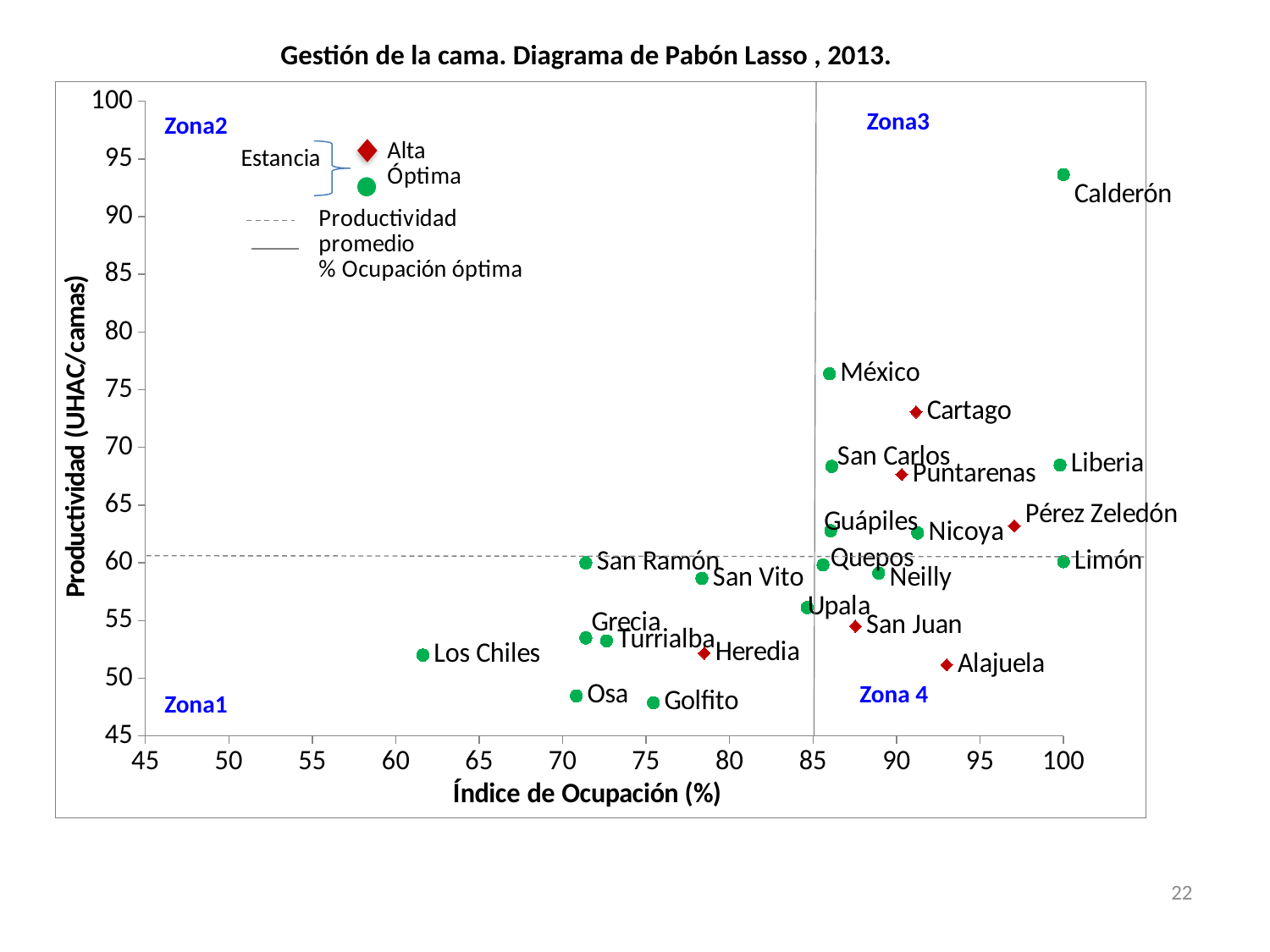
Which has the higher Productividad, Liberia or Limón? Liberia Which hospital has the lowest Índice de Ocupación (%)? Los Chiles Is the Productividad value for Cartago greater or less than 70? greater Which has the higher Índice de Ocupación, Los Chiles or Alajuela? Alajuela Which has the higher Productividad, Cartago or San Carlos? Cartago Is the Productividad value for Calderón greater or less than 90? greater Is the Productividad value for Alajuela greater or less than 55? less What is the title of the chart? Gestión de la cama. Diagrama de Pabón Lasso , 2013. Which hospital has the highest Productividad (UHAC/camas)? Calderón What kind of chart is shown on the slide? Scatter chart What are the two 'Estancia' categories listed in the legend? Alta and Óptima